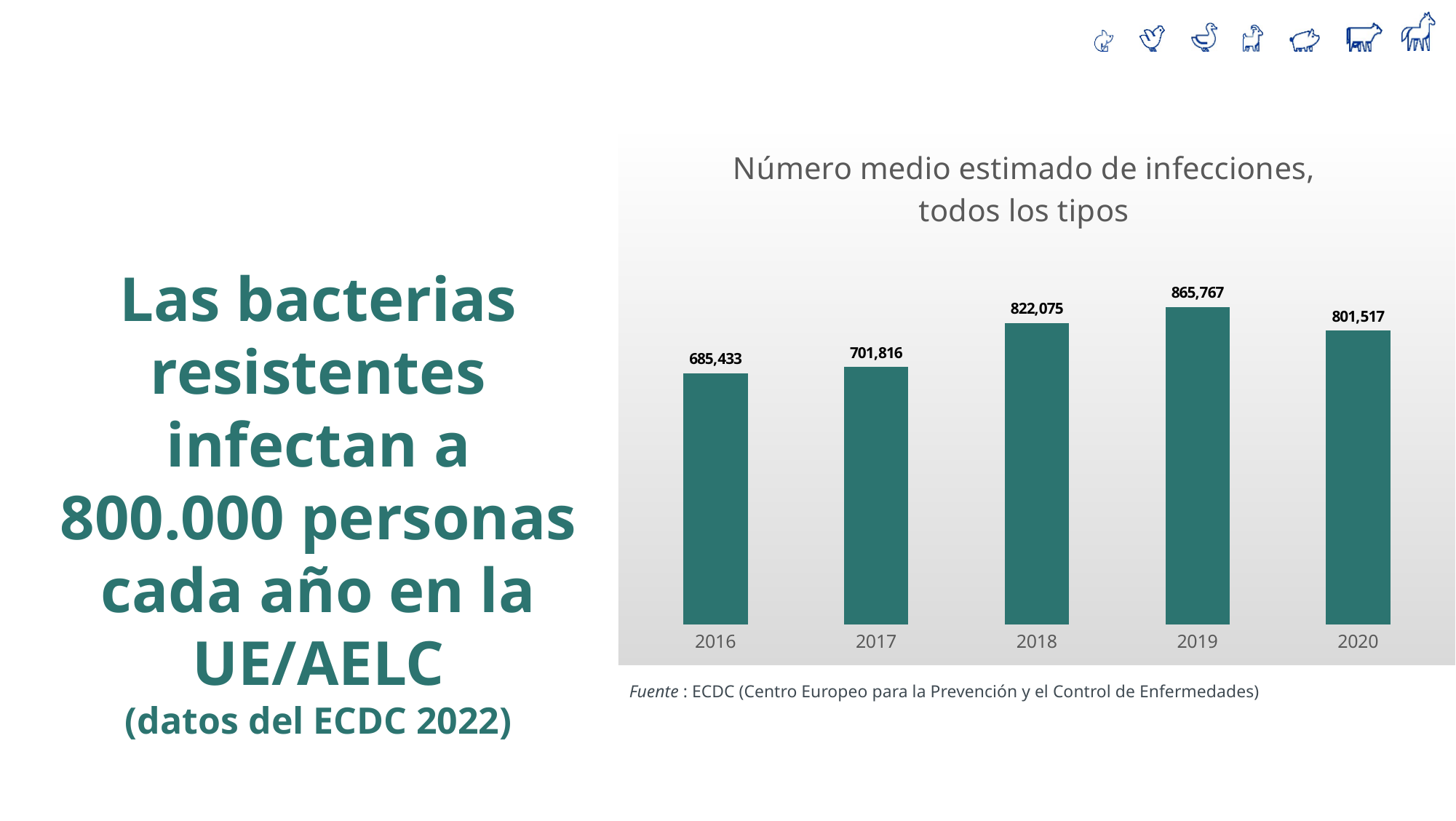
What is the value for 2019? 865,767 What is the title of the chart? Número medio estimado de infecciones, todos los tipos Do the values rise or fall from 2016 to 2019? Rise What kind of chart is shown? Bar chart Which is larger, the value for 2018 or the value for 2020? 2018 What is the value for 2020? 801,517 How many years are shown on the x axis? 5 Which year has the highest value? 2019 What is the difference between the values for 2017 and 2016? 16,383 What is the value for 2016? 685,433 Which year has the lowest value? 2016 What is the difference between the values for 2019 and 2018? 43,692